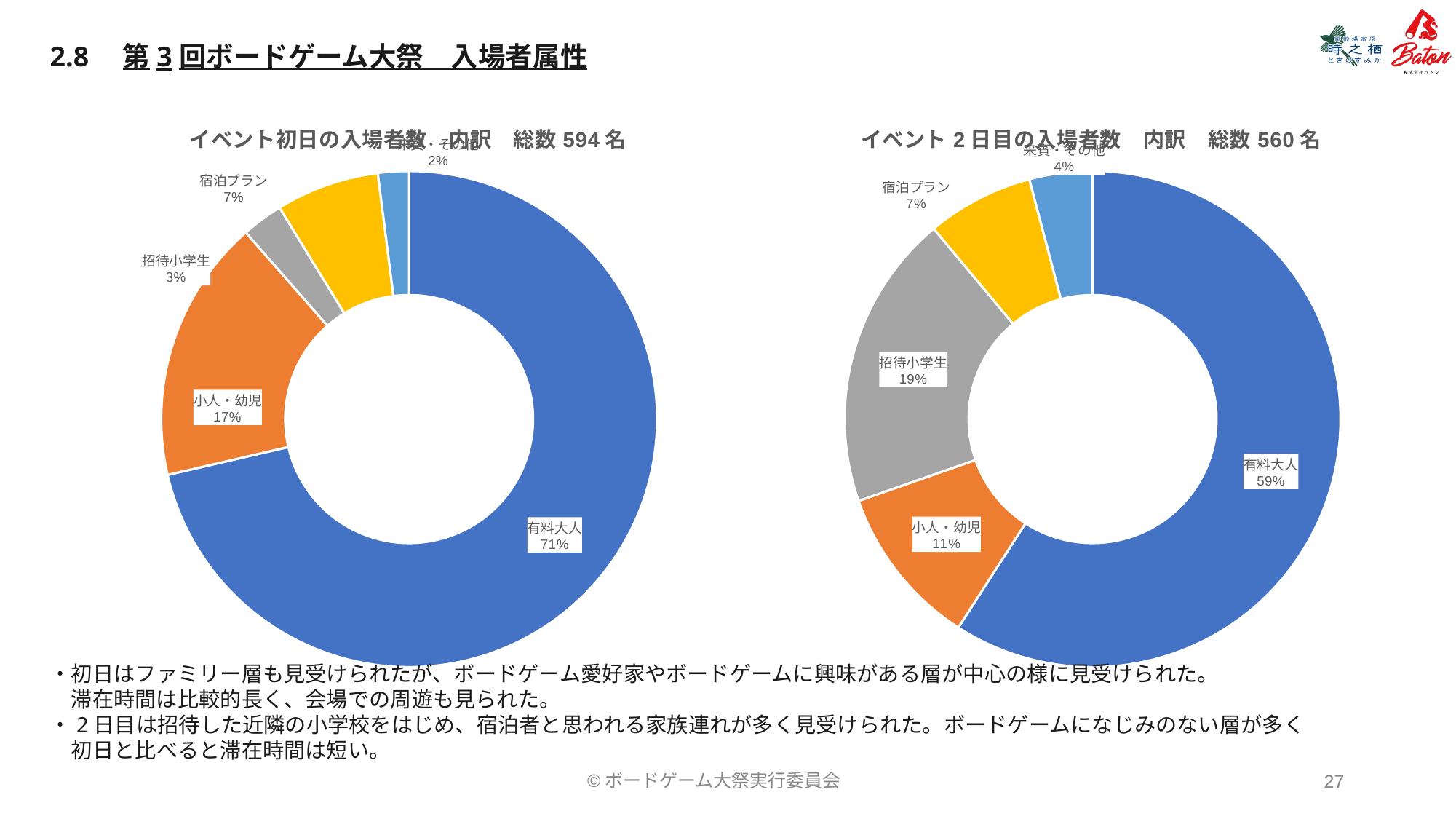
In the イベント初日の入場者数 chart, what share is 招待小学生? 3% In the イベント初日の入場者数 chart, what share is 小人・幼児? 17% In the イベント初日の入場者数 chart, what share is 有料大人? 71% What kind of chart is used for イベント初日の入場者数 内訳? Doughnut (pie) chart In the イベント初日の入場者数 chart, which category has the largest share? 有料大人 In the イベント2日目の入場者数 chart, what share is 宿泊プラン? 7% In the イベント2日目の入場者数 chart, what share is 小人・幼児? 11% How many categories are shown in the イベント2日目の入場者数 chart? 5 In the イベント2日目の入場者数 chart, which is larger, 招待小学生 or 小人・幼児? 招待小学生 In the イベント2日目の入場者数 chart, what share is 招待小学生? 19% What total number of attendees is stated in the title of the イベント2日目の入場者数 chart? 560名 What is the difference in the 有料大人 share between the イベント初日 chart and the イベント2日目 chart? 12 percentage points